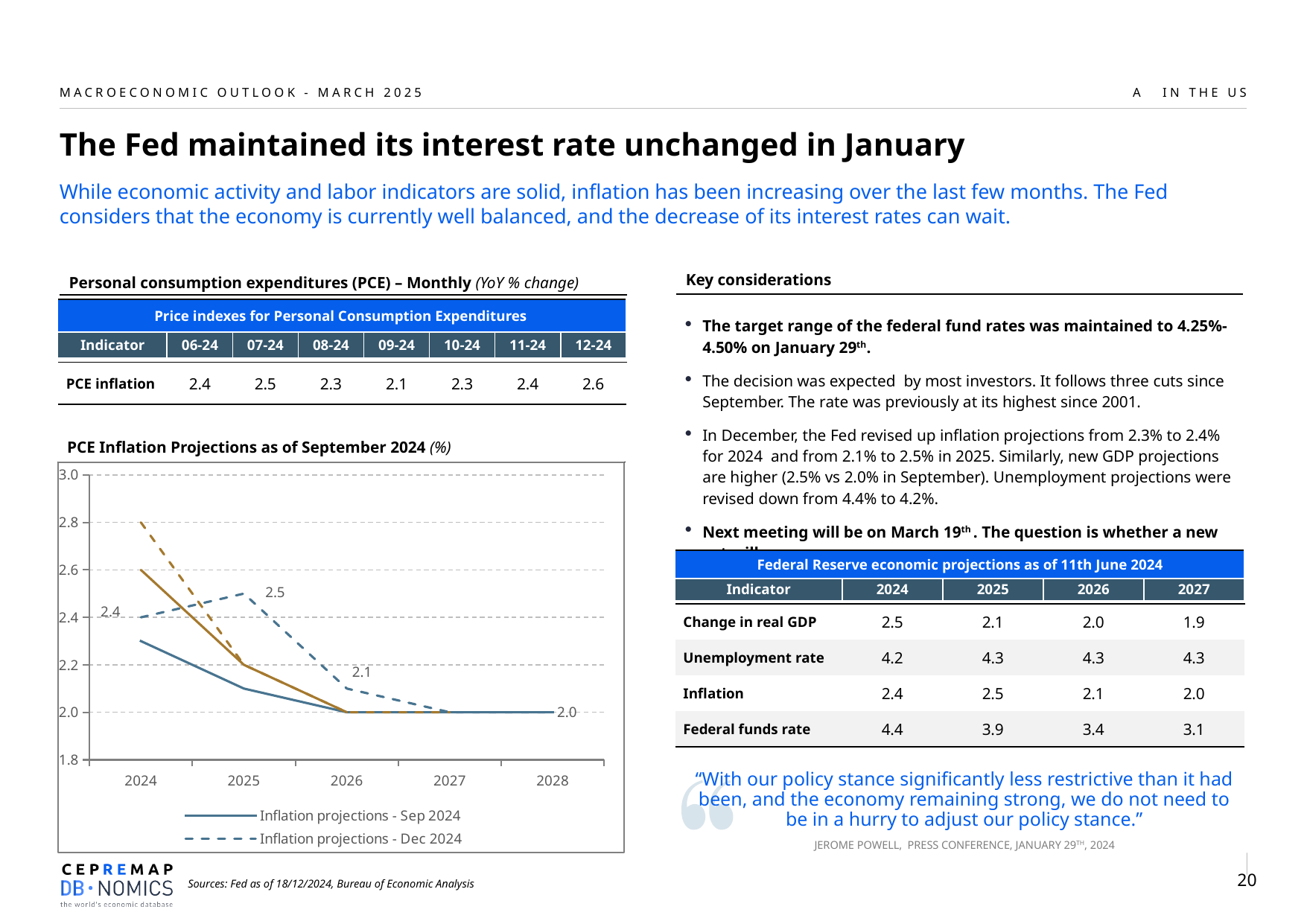
How many series does the legend of the PCE Inflation Projections chart list? 2 In the PCE Inflation Projections chart, in which year does the Dec 2024 inflation projection reach its highest labelled value? 2025 How many years are shown on the x axis of the PCE Inflation Projections chart? 5 In the PCE Inflation Projections chart, what is the labelled value of the inflation projection for 2028? 2.0 What kind of chart is the 'PCE Inflation Projections as of September 2024' chart? line chart In the PCE Inflation Projections chart, do the Sep 2024 inflation projections rise or fall from 2024 to 2028? fall In the PCE Inflation Projections chart, is the Dec 2024 projection higher for 2025 or for 2026? 2025 In the PCE Inflation Projections chart, what is the labelled value of the Dec 2024 inflation projection for 2025? 2.5 In the PCE Inflation Projections chart, what is the labelled value of the Dec 2024 inflation projection for 2026? 2.1 In the PCE Inflation Projections chart, is the Sep 2024 inflation projection for 2024 greater or less than 2.4? less In the PCE Inflation Projections chart, what is the difference between the Dec 2024 projection for 2025 and for 2026? 0.4 In the PCE Inflation Projections chart, what is the labelled value of the Dec 2024 inflation projection for 2024? 2.4